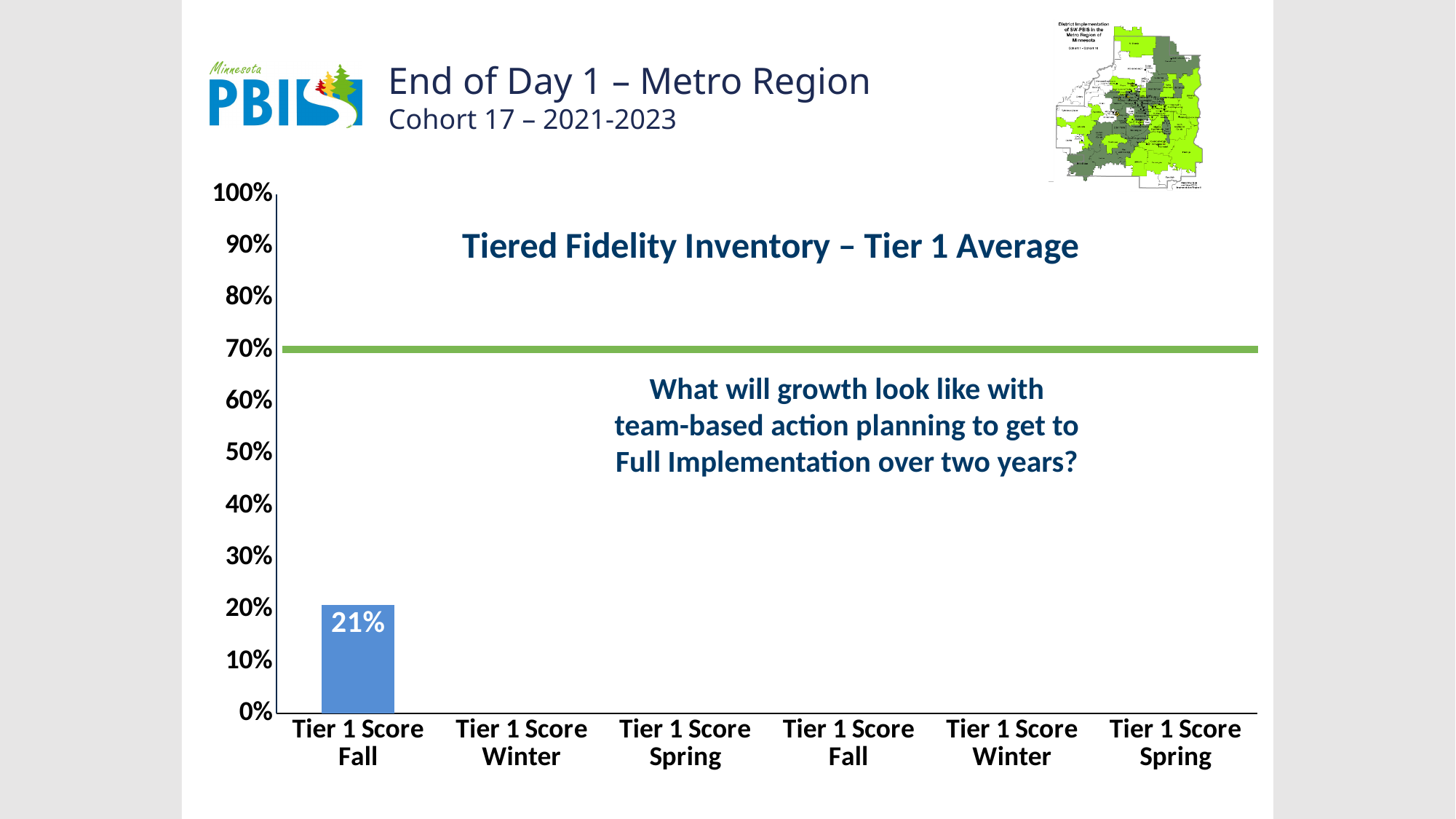
What is the title of the chart? Tiered Fidelity Inventory – Tier 1 Average Is the value for the first Tier 1 Score Fall bar greater or less than 30%? less Is the value for the first Tier 1 Score Fall bar greater or less than 20%? greater Which category has the highest plotted value on the chart? Tier 1 Score Fall (first) How many bars have a plotted value on the chart? 1 What is the maximum value shown on the y axis of the chart? 100% How many categories are shown on the x axis of the chart? 6 What is the label of the last category on the x axis? Tier 1 Score Spring What kind of chart is shown on the slide? bar chart What is the value of the first Tier 1 Score Fall bar? 21% At what percentage level is the green horizontal line drawn on the chart? 70%